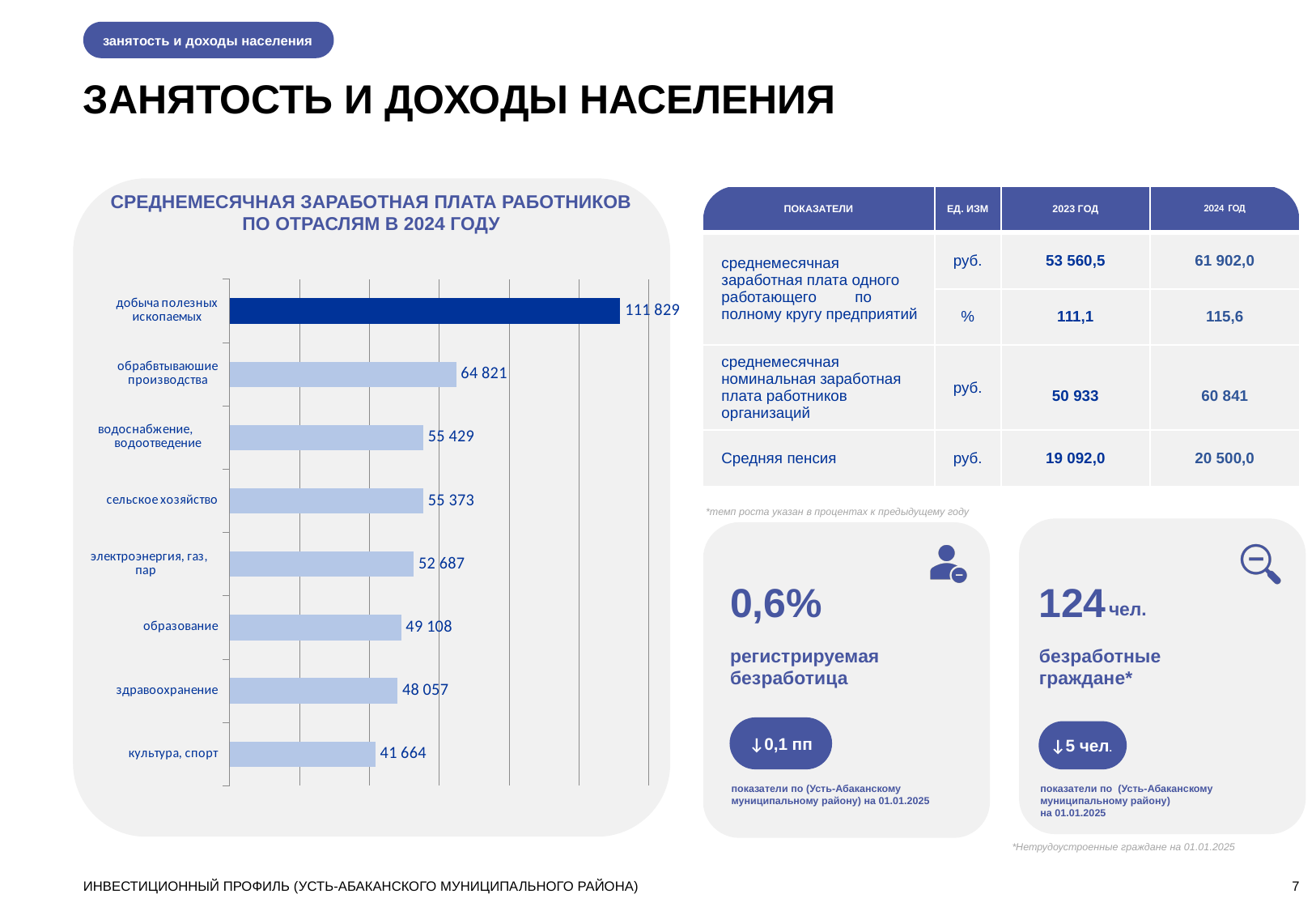
What kind of chart is used to show average monthly salary by industry? bar chart What value does the chart show for культура, спорт? 41 664 What is the average monthly salary shown for добыча полезных ископаемых in the chart? 111 829 Which is larger: the value for электроэнергия, газ, пар or the value for здравоохранение? электроэнергия, газ, пар Which industry has the lowest average monthly salary in the chart? культура, спорт Which industry has the highest average monthly salary in the chart? добыча полезных ископаемых What is the difference between the values for образование and здравоохранение? 1 051 Do the bar values increase or decrease going from the top category to the bottom category? decrease What is the difference between the values for добыча полезных ископаемых and обрабатывающие производства? 47 008 What value does the chart show for образование? 49 108 Which year does the chart title say the salary data refers to? 2024 How many industries are shown in the chart? 8